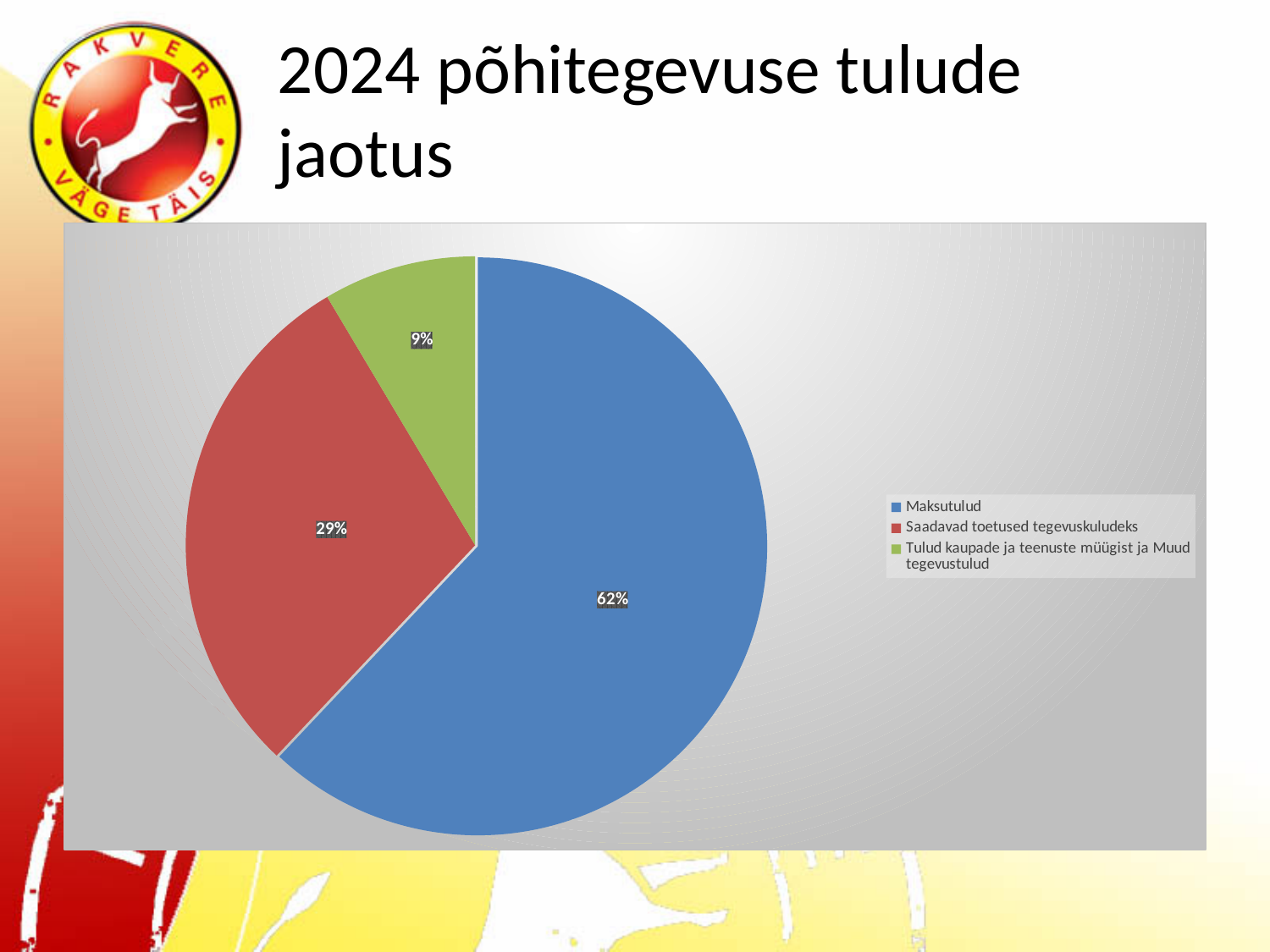
Which category has the smallest slice of the pie? Tulud kaupade ja teenuste müügist ja Muud tegevustulud What share of the pie does Saadavad toetused tegevuskuludeks represent? 29% What share of the pie does Tulud kaupade ja teenuste müügist ja Muud tegevustulud represent? 9% What is the title of the slide containing the chart? 2024 põhitegevuse tulude jaotus How many categories does the pie chart have? 3 Which is larger: the share for Saadavad toetused tegevuskuludeks or the share for Tulud kaupade ja teenuste müügist ja Muud tegevustulud? Saadavad toetused tegevuskuludeks What share of the pie does Maksutulud represent? 62% What colour is the slice for Maksutulud? blue What kind of chart is shown on the slide? pie chart Which category has the largest slice of the pie? Maksutulud What is the difference in percentage points between Saadavad toetused tegevuskuludeks and Tulud kaupade ja teenuste müügist ja Muud tegevustulud? 20% What is the difference in percentage points between Maksutulud and Saadavad toetused tegevuskuludeks? 33%